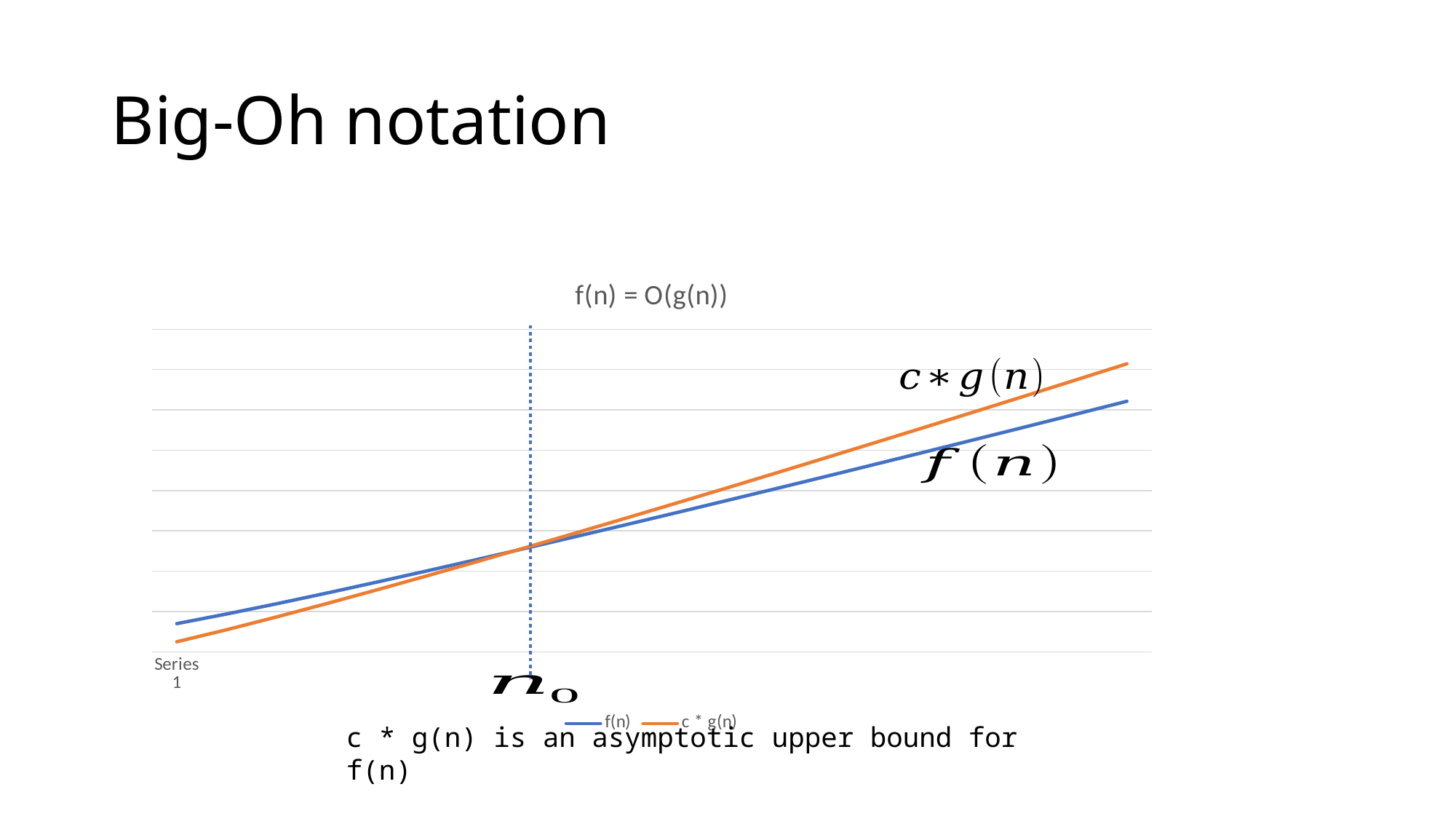
Which series is drawn in orange? c * g(n) At the right end of the chart, which series has the higher value, f(n) or c * g(n)? c * g(n) What kind of chart is shown on the slide? line chart At the left end of the chart, which series has the higher value, f(n) or c * g(n)? f(n) Which series has the lowest value on the chart? c * g(n) Do the values of the f(n) series rise or fall from left to right? rise What is the title of the chart? f(n) = O(g(n)) Which series reaches the highest value on the chart? c * g(n) Do the values of the c * g(n) series rise or fall from left to right? rise How many series does the chart's legend list? 2